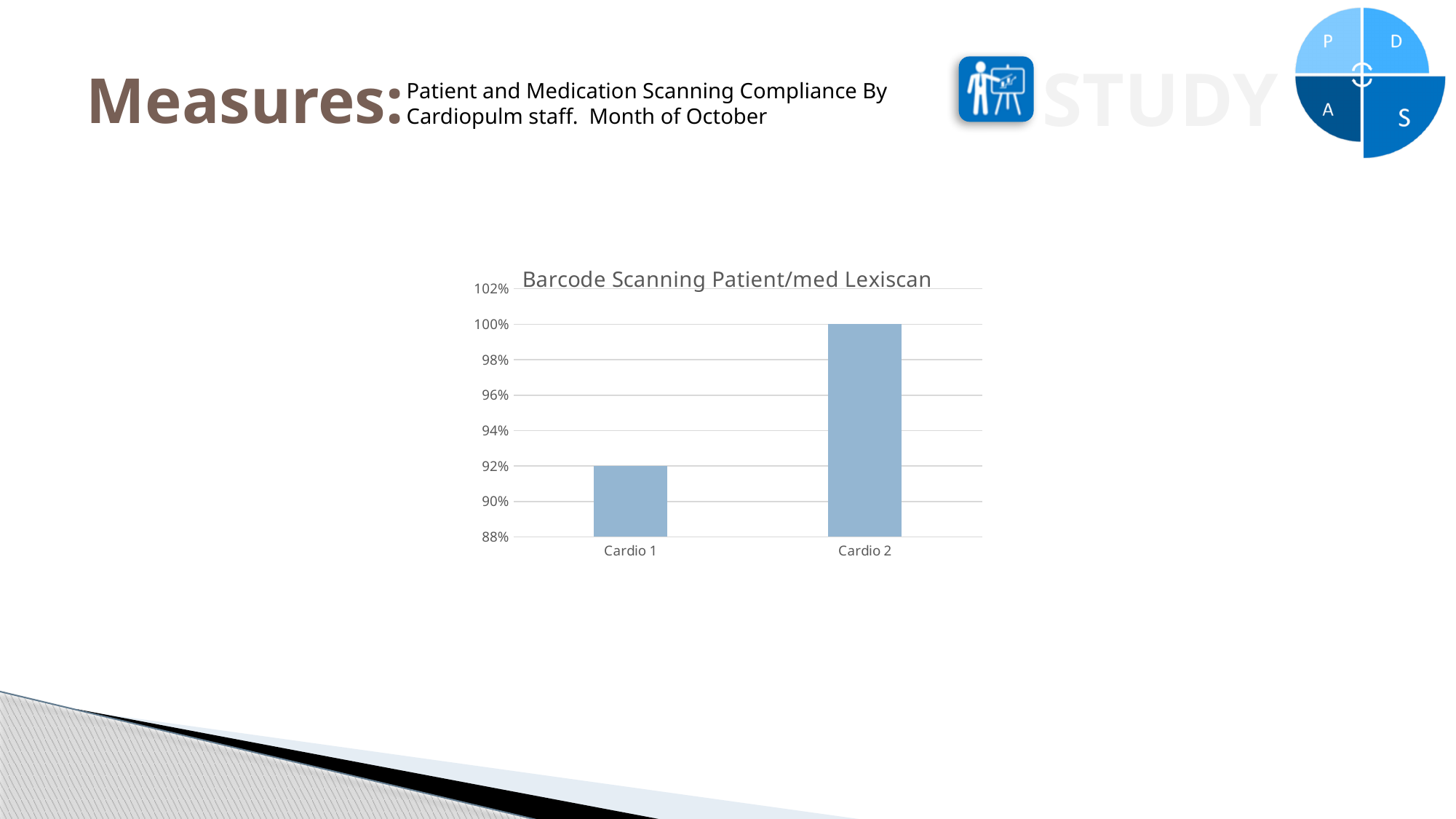
What is the title of the chart? Barcode Scanning Patient/med Lexiscan What is the value for Cardio 1? 92% Is the value for Cardio 1 greater or less than 96%? less Is the value for Cardio 2 greater or less than 98%? greater What is the difference between the values for Cardio 2 and Cardio 1? 8% What kind of chart is shown on the slide? bar chart Which category has the lowest value? Cardio 1 What is the value for Cardio 2? 100% Which is larger, the value for Cardio 1 or the value for Cardio 2? Cardio 2 Which category has the highest value? Cardio 2 How many categories are shown on the x axis? 2 Do the values rise or fall from Cardio 1 to Cardio 2? rise